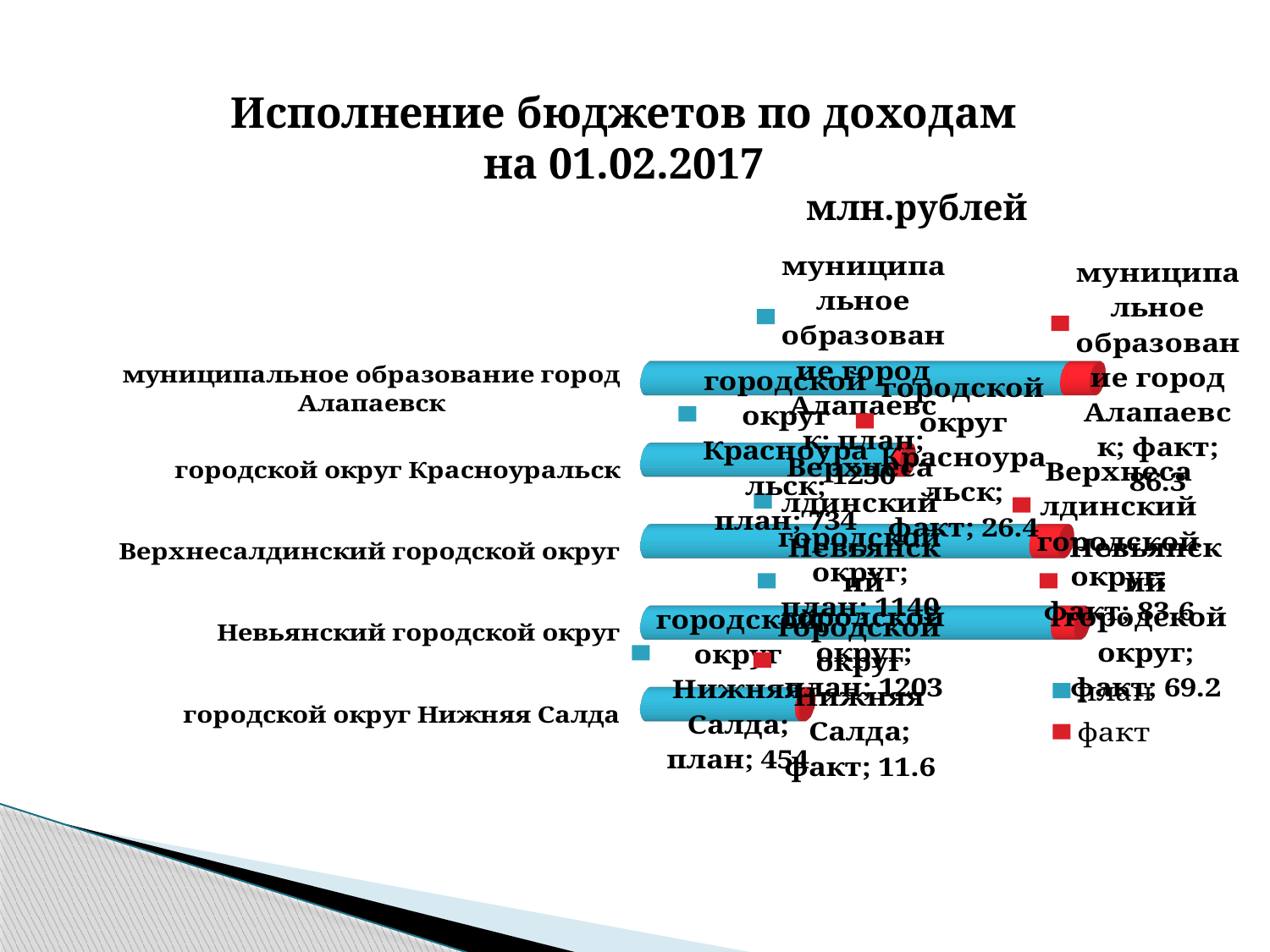
How many series does the legend list? 2 Which category has the highest план value? муниципальное образование город Алапаевск What is the план value for муниципальное образование город Алапаевск? 1230 Which is larger, the план value for Невьянский городской округ or the план value for Верхнесалдинский городской округ? Невьянский городской округ What kind of chart is shown on the slide? bar chart What is the факт value for городской округ Красноуральск? 26.4 What is the факт value for Невьянский городской округ? 69.2 How many categories are shown in the chart? 5 Which category has the lowest факт value? городской округ Нижняя Салда What is the план value for городской округ Нижняя Салда? 454 What is the difference between the план and факт values for городской округ Нижняя Салда? 442.4 What is the план value for Верхнесалдинский городской округ? 1140